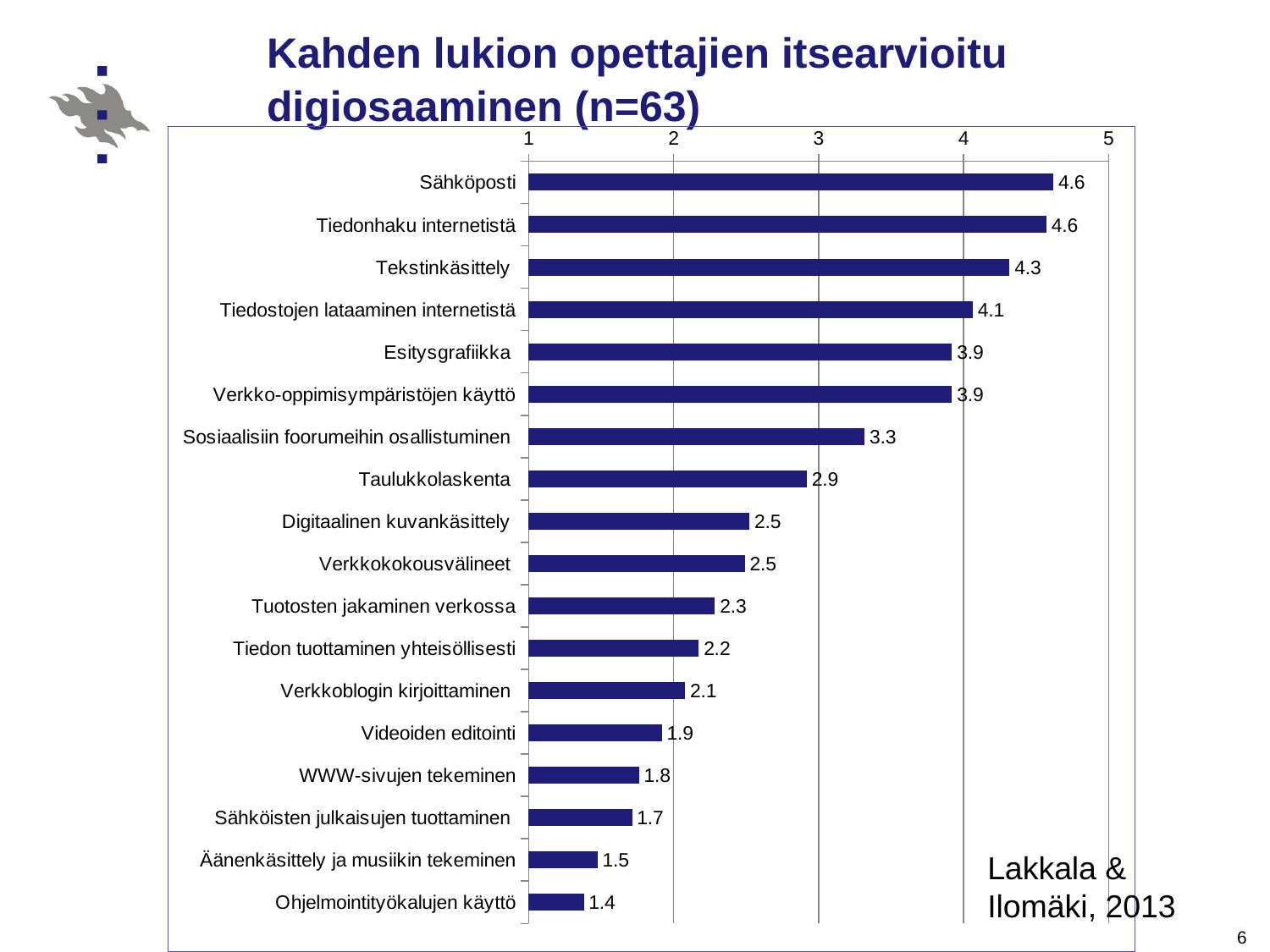
What is the title of the chart on the slide? Kahden lukion opettajien itsearvioitu digiosaaminen (n=63) How many categories are shown in the chart? 18 What is the value for Taulukkolaskenta? 2.9 What kind of chart is shown on the slide? bar chart Which category has the lowest value? Ohjelmointityökalujen käyttö What is the value for Videoiden editointi? 1.9 What is the value for Sosiaalisiin foorumeihin osallistuminen? 3.3 Is the value for WWW-sivujen tekeminen greater or less than 2? less What is the difference between the values for Tiedostojen lataaminen internetistä and Taulukkolaskenta? 1.2 Which is larger, the value for Esitysgrafiikka or the value for Verkkoblogin kirjoittaminen? Esitysgrafiikka What is the difference between the values for Sähköposti and Ohjelmointityökalujen käyttö? 3.2 What is the value for Tekstinkäsittely? 4.3